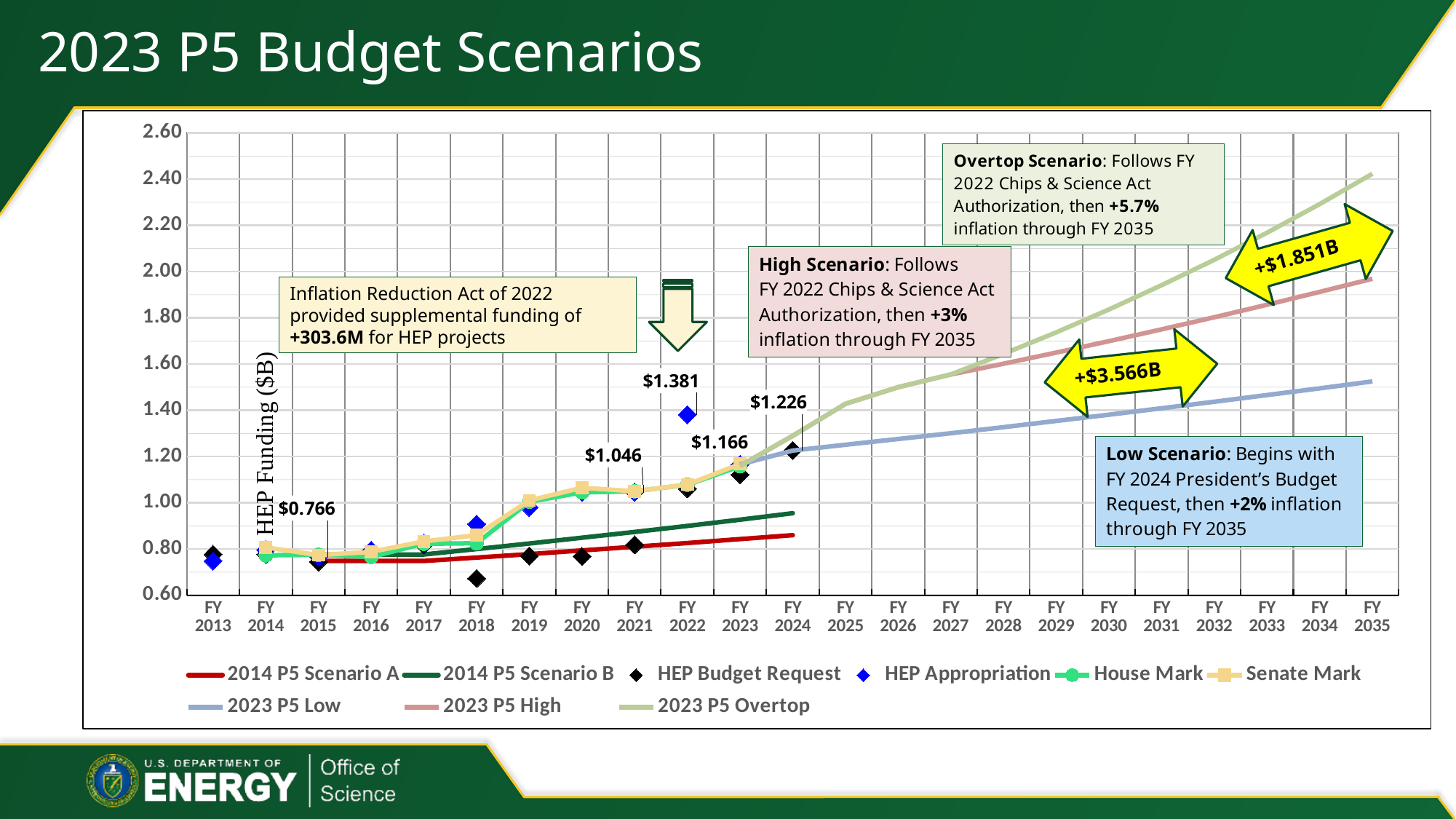
What is the difference between the labeled FY 2022 value of $1.381 and the labeled FY 2023 value of $1.166? $0.215 At FY 2035, is the 2023 P5 Low line greater or less than 1.40? greater Does the 2023 P5 Low line rise or fall from FY 2024 to FY 2035? rise What is the labeled HEP Appropriation value for FY 2022? $1.381 What is the labeled value at FY 2024? $1.226 How many fiscal years are shown along the x axis? 23 What is the labeled value at FY 2021? $1.046 What type of chart is shown on the slide? line chart At FY 2035, is the 2023 P5 Overtop line greater or less than 2.20? greater At FY 2035, which is higher: the 2023 P5 High line or the 2023 P5 Low line? 2023 P5 High How many series does the legend list? 9 Which scenario line reaches the highest value at FY 2035? 2023 P5 Overtop